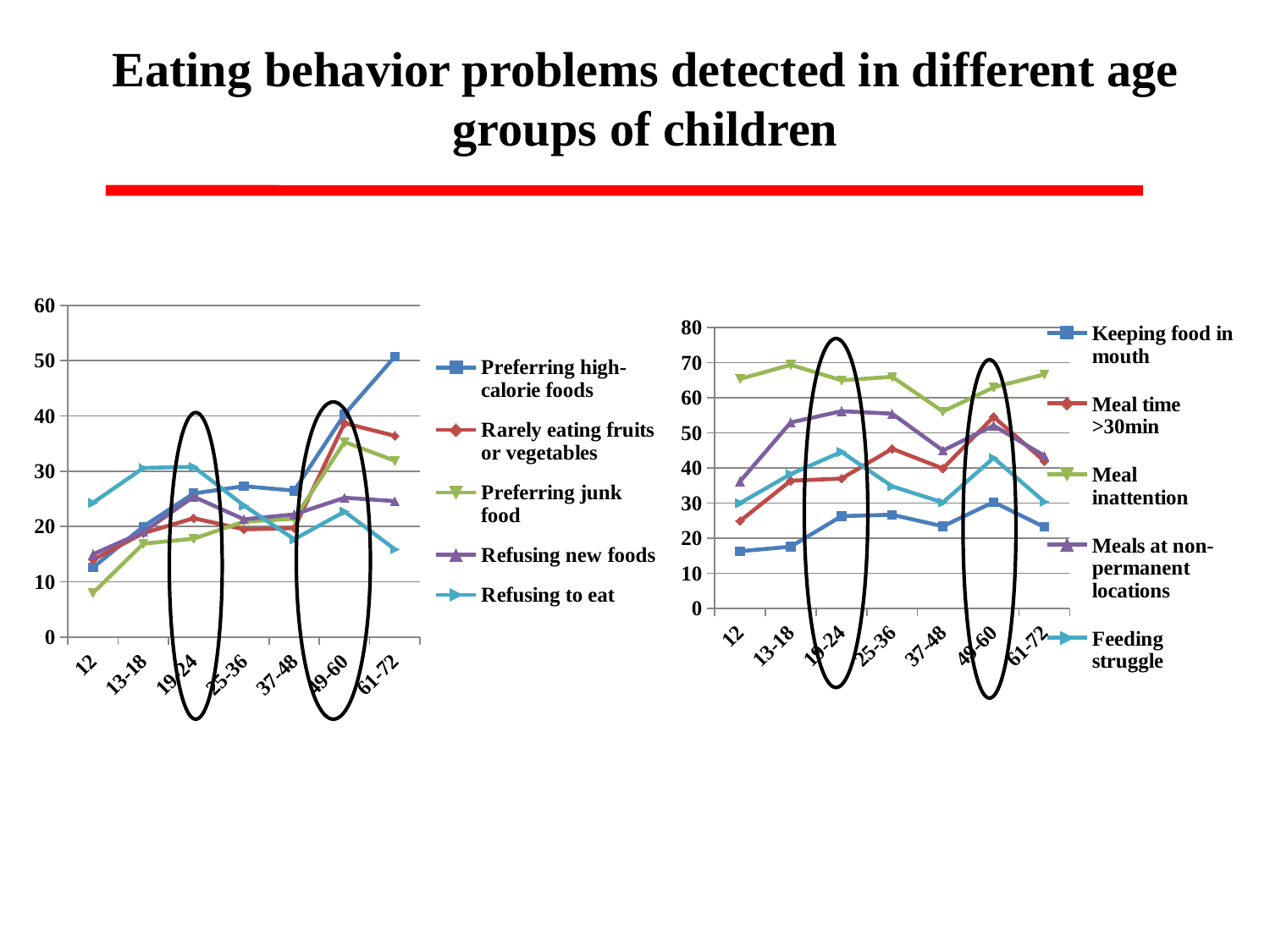
What kind of chart is the chart on the left of the slide? line chart In the right chart, at 61-72, which is larger: Meal inattention or Keeping food in mouth? Meal inattention In the left chart, does the Preferring high-calorie foods line overall rise or fall from 12 to 61-72? rise In the right chart, is the value for Keeping food in mouth at 12 greater or less than 20? less How many age groups are shown on the x axis of the right chart? 7 In the left chart, which series has the highest value at 61-72? Preferring high-calorie foods In the left chart, which series has the lowest value at 12? Preferring junk food In the left chart, is the value for Preferring junk food at 12 greater or less than 10? less How many series does the legend of the left chart list? 5 In the right chart, which series has the lowest value at 12? Keeping food in mouth In the right chart, which series has the highest value at 12? Meal inattention In the left chart, is the value for Preferring high-calorie foods at 61-72 greater or less than 40? greater